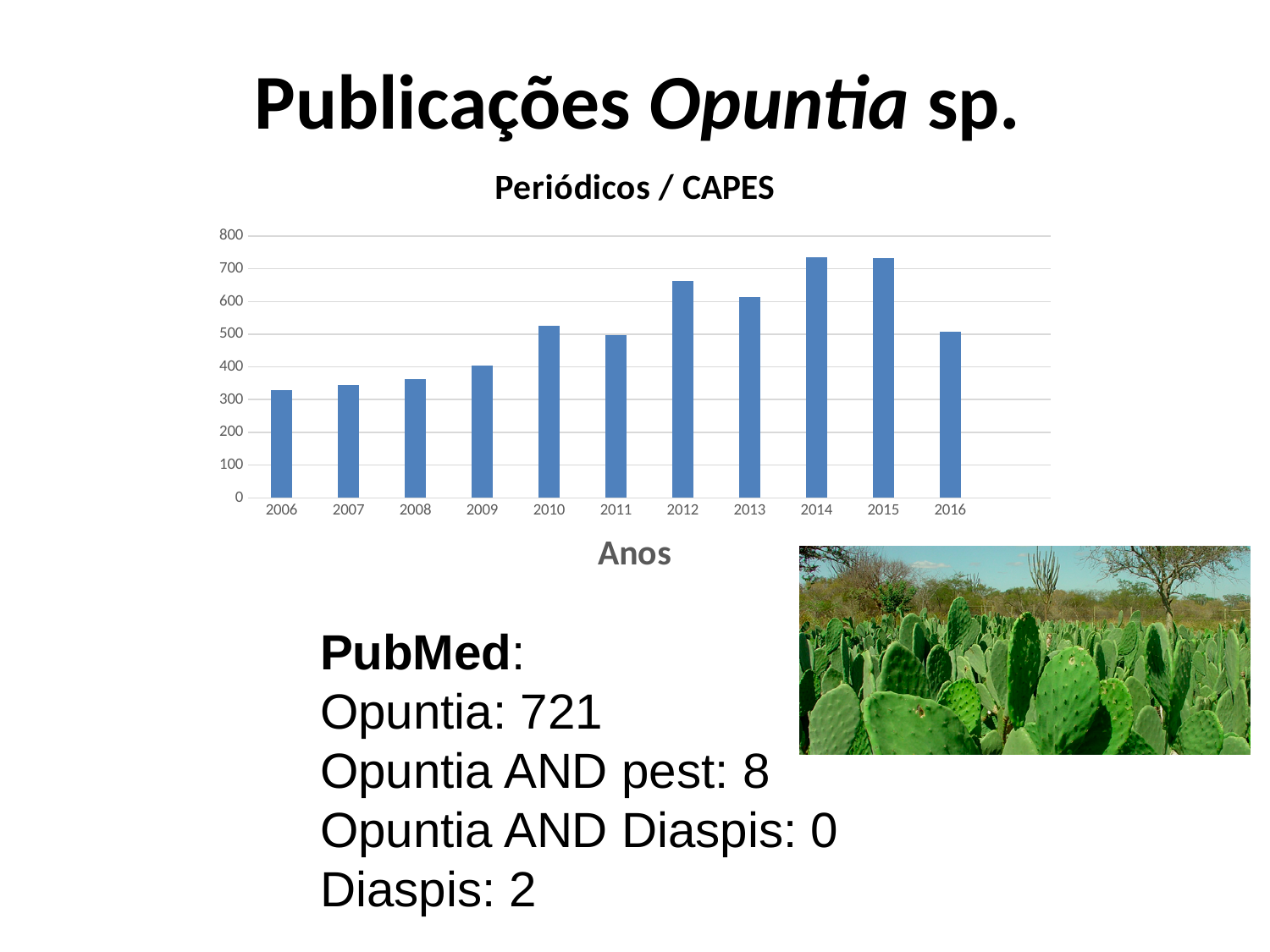
How many years are shown on the x axis of the chart? 11 What is the title of the chart? Periódicos / CAPES What kind of chart is shown under the title "Periódicos / CAPES"? bar chart Is the value for 2008 greater or less than 400? less Which year has the higher value, 2014 or 2016? 2014 Is the value for 2006 greater or less than 300? greater Is the value for 2014 greater or less than 800? less Do the values rise or fall from 2006 to 2010? rise What is the label of the x axis of the chart? Anos Which year has the higher value, 2012 or 2013? 2012